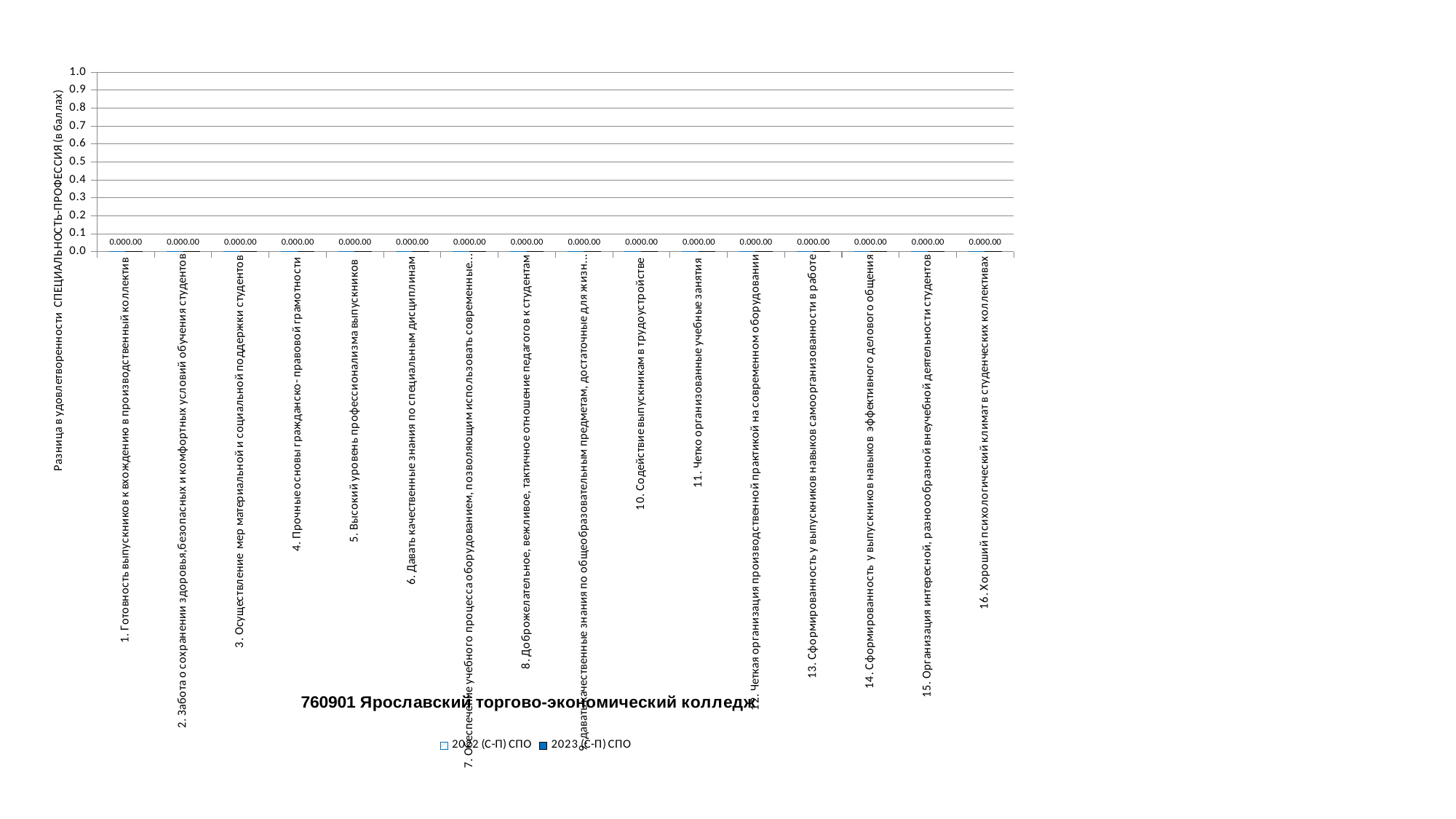
What kind of chart is shown on the slide? bar chart What data label is printed for category "1. Готовность выпускников к вхождению в производственный коллектив"? 0.00 What are the two series named in the chart's legend? 2022 (С-П) СПО and 2023 (С-П) СПО How many categories are shown along the x axis of the chart? 16 How many series does the chart's legend list? 2 What is the highest value shown on the y axis of the chart? 1.0 What data label is printed for category "10. Содействие выпускникам в трудоустройстве"? 0.00 Is the value for "4. Прочные основы гражданско-правовой грамотности" greater or less than 0.1? less What data label is printed for category "16. Хороший психологический климат в студенческих коллективах"? 0.00 Is the value for "11. Четко организованные учебные занятия" greater or less than 0.5? less What data label is printed for category "5. Высокий уровень профессионализма выпускников"? 0.00 What is the title of the chart? 760901 Ярославский торгово-экономический колледж